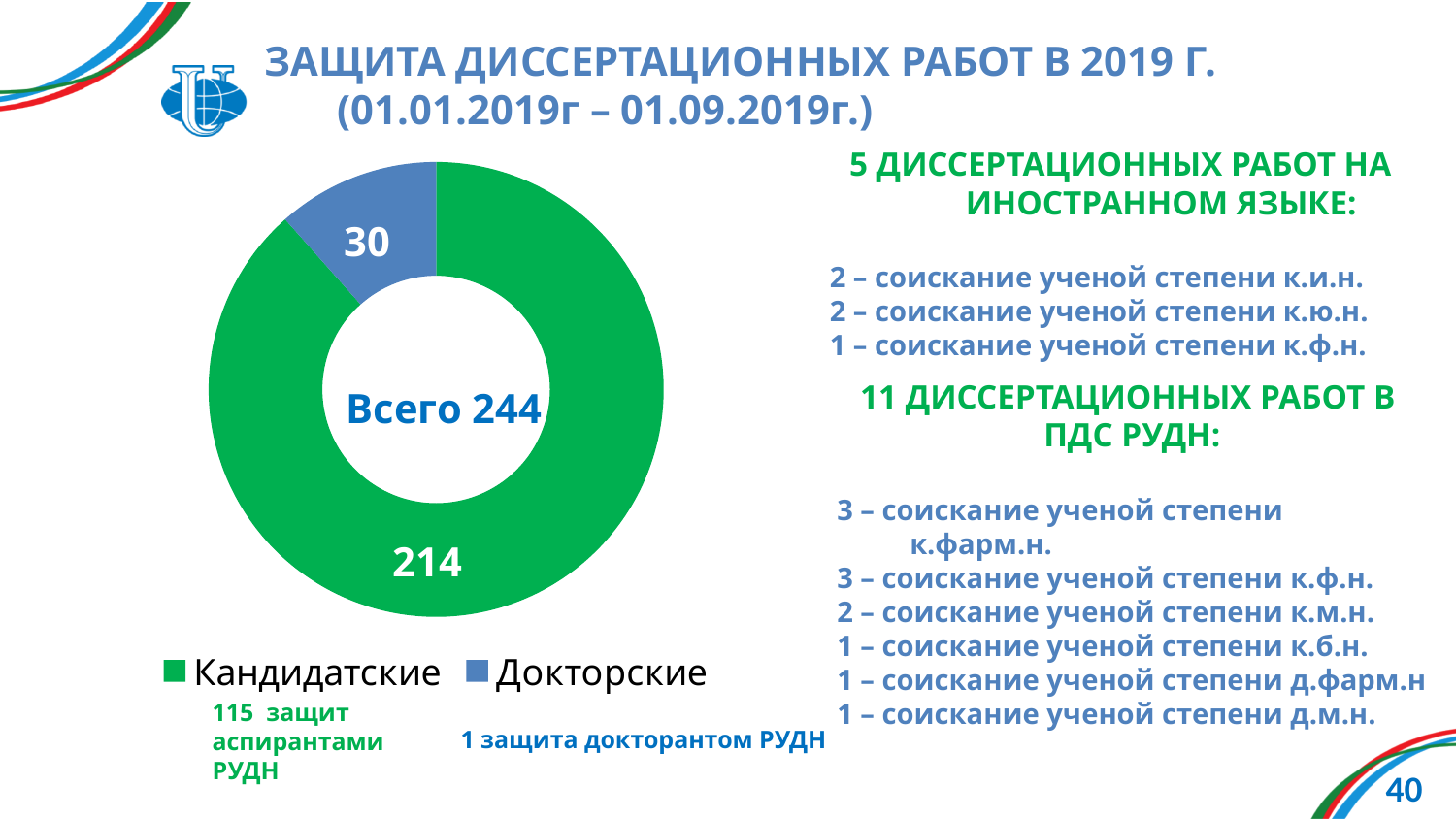
What colour is the Кандидатские slice? green How many categories does the chart show? 2 Which category has the largest slice in the chart? Кандидатские Which category has the smallest slice in the chart? Докторские What value is shown for Докторские in the chart? 30 How many entries does the chart legend list? 2 What kind of chart is shown on the slide? doughnut chart What value is shown for Кандидатские in the chart? 214 What total is printed in the centre of the chart? Всего 244 Which is larger, Кандидатские or Докторские? Кандидатские What is the difference between the Кандидатские and Докторские values? 184 What share of the total do Докторские make up? 12.3%